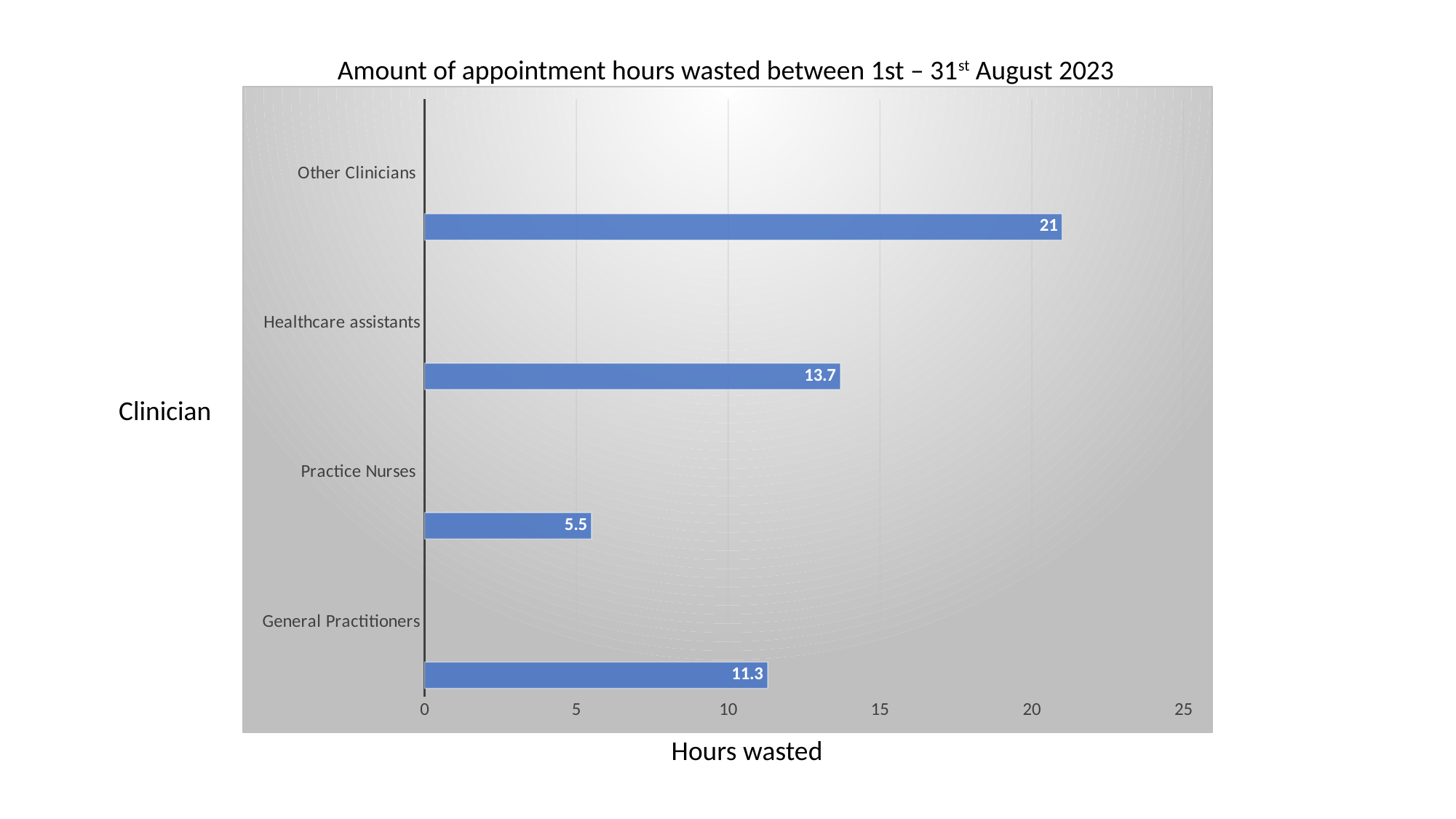
How many hours were wasted for Practice Nurses? 5.5 Which clinician group has the highest number of hours wasted? Other Clinicians How many hours were wasted for Other Clinicians? 21 How many clinician categories are shown in the chart? 4 How many hours were wasted for General Practitioners? 11.3 What type of chart is shown on the slide? bar chart What is the label of the horizontal axis? Hours wasted What is the title of the chart? Amount of appointment hours wasted between 1st – 31st August 2023 Which has more hours wasted, General Practitioners or Healthcare assistants? Healthcare assistants What is the difference in hours wasted between Other Clinicians and Healthcare assistants? 7.3 How many hours were wasted for Healthcare assistants? 13.7 Which clinician group has the lowest number of hours wasted? Practice Nurses